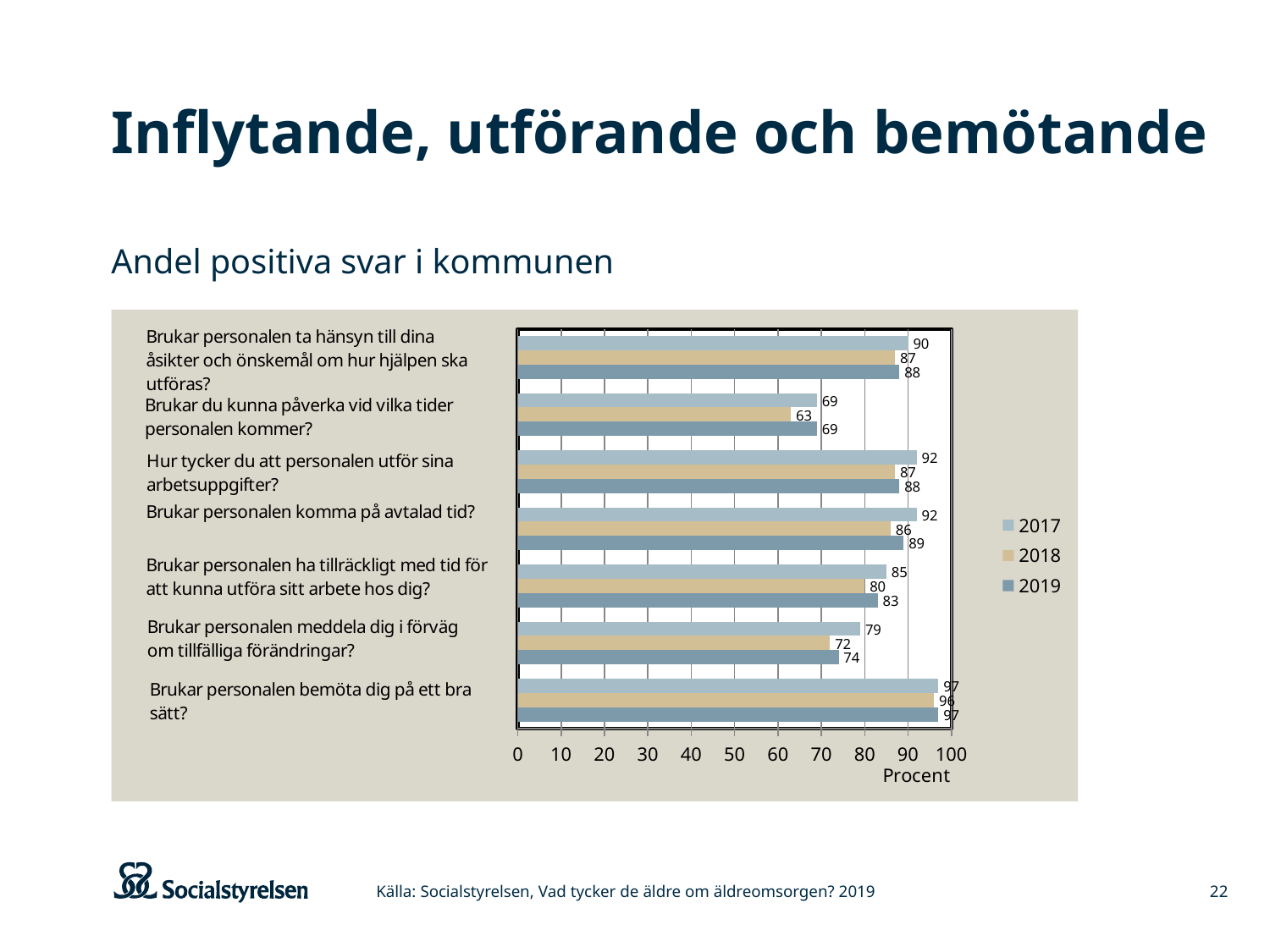
What is the 2018 value for "Brukar du kunna påverka vid vilka tider personalen kommer?"? 63 Which question has the lowest 2018 value? Brukar du kunna påverka vid vilka tider personalen kommer? What is the 2019 value for "Brukar personalen meddela dig i förväg om tillfälliga förändringar?"? 74 Which question has the highest 2019 value? Brukar personalen bemöta dig på ett bra sätt? How many questions (categories) are shown in the chart? 7 What is the 2017 value for "Brukar personalen komma på avtalad tid?"? 92 Is the 2018 value for "Brukar personalen komma på avtalad tid?" greater or less than 80? greater What is the label on the horizontal axis of the chart? Procent What is the difference between the 2017 and 2018 values for "Brukar personalen meddela dig i förväg om tillfälliga förändringar?"? 7 For "Brukar personalen ha tillräckligt med tid för att kunna utföra sitt arbete hos dig?", which year has the larger value, 2017 or 2019? 2017 How many series does the legend list? 3 What kind of chart is shown on the slide? Bar chart